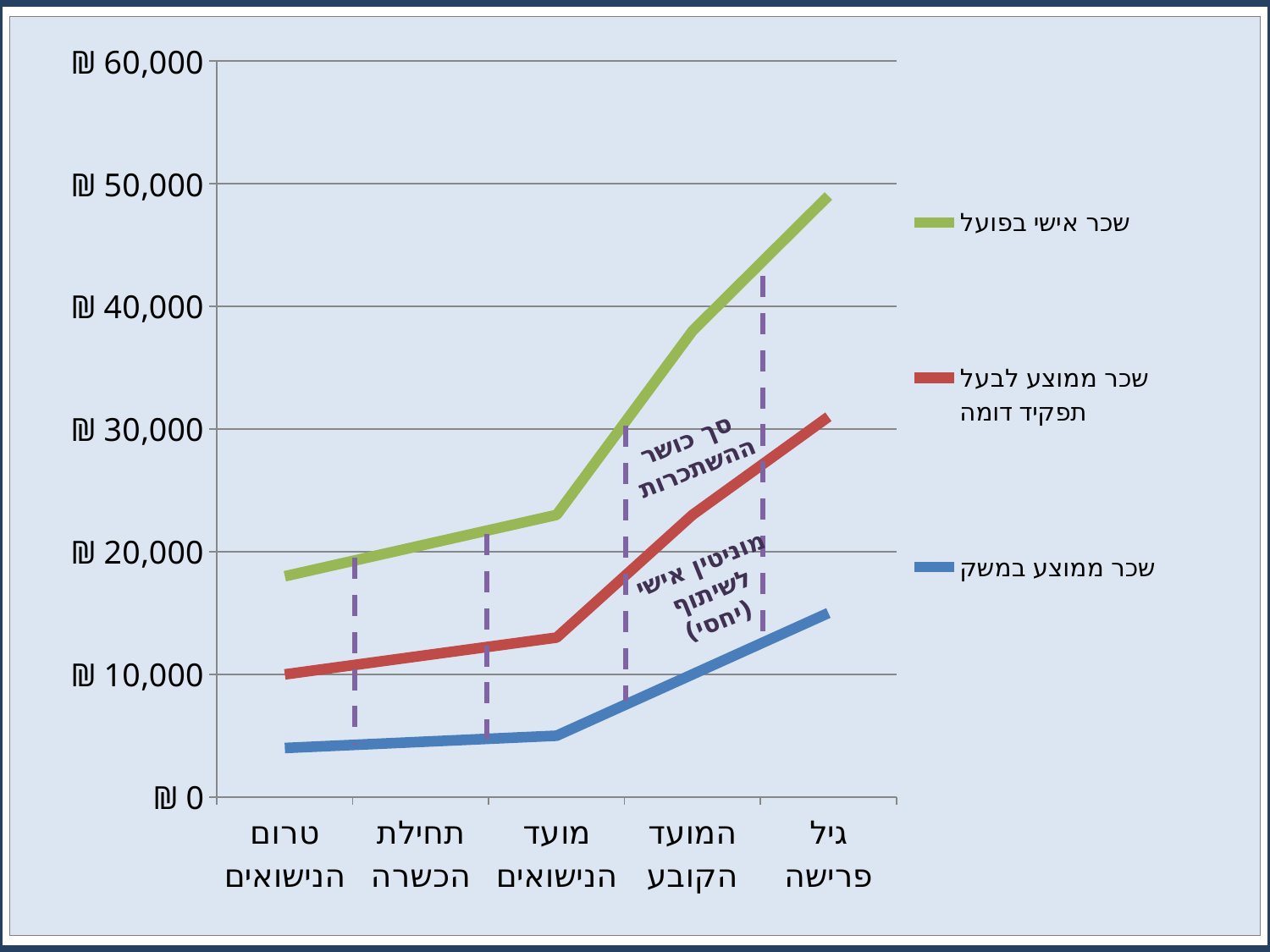
Is the value of שכר ממוצע במשק at מועד הנישואים greater or less than ₪10,000? less Is the value of שכר ממוצע לבעל תפקיד דומה at המועד הקובע greater or less than ₪20,000? greater Is the value of שכר אישי בפועל at גיל פרישה greater or less than ₪40,000? greater At which category does שכר אישי בפועל reach its highest value? גיל פרישה At which category is שכר ממוצע לבעל תפקיד דומה lowest? טרום הנישואים At גיל פרישה, which is larger: שכר אישי בפועל or שכר ממוצע במשק? שכר אישי בפועל Do the values of שכר ממוצע במשק rise or fall from טרום הנישואים to גיל פרישה? rise How many categories are shown along the x axis? 5 What kind of chart is shown on the slide? line chart How many series does the legend list? 3